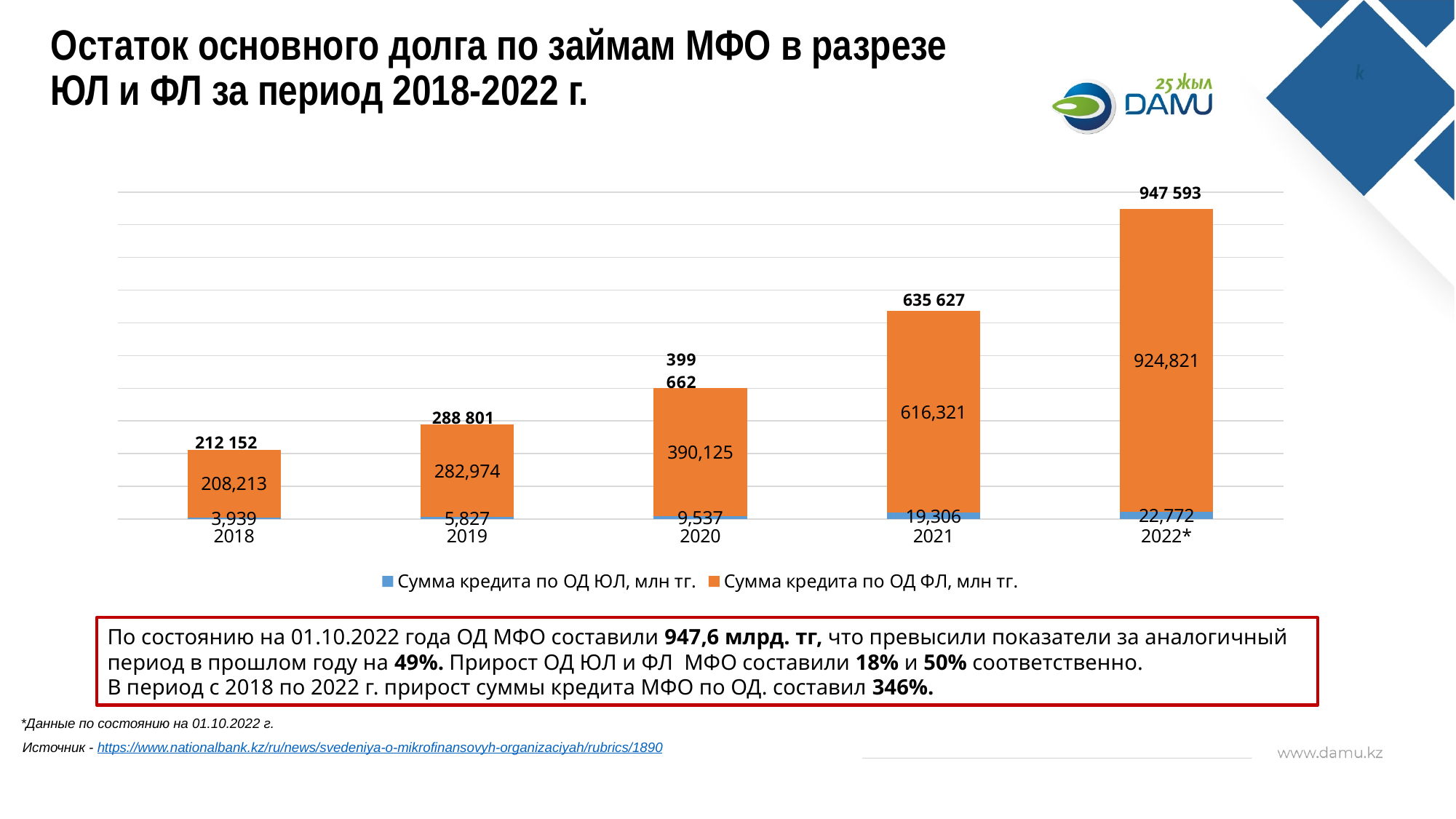
What is the value of "Сумма кредита по ОД ФЛ, млн тг." for 2020? 390,125 Which year has the lowest value for "Сумма кредита по ОД ЮЛ, млн тг."? 2018 What is the value of "Сумма кредита по ОД ЮЛ, млн тг." for 2021? 19,306 What kind of chart is shown on the slide? Stacked bar chart Which year has the highest value for "Сумма кредита по ОД ФЛ, млн тг."? 2022* What is the difference between the "Сумма кредита по ОД ФЛ, млн тг." values for 2022* and 2021? 308,500 What total is printed above the bar for 2022*? 947 593 Do the total values of the stacked bars rise or fall from 2018 to 2022*? Rise How many series does the legend list? 2 Which year has the larger value for "Сумма кредита по ОД ЮЛ, млн тг.": 2019 or 2020? 2020 What is the difference between the "Сумма кредита по ОД ЮЛ, млн тг." values for 2021 and 2020? 9,769 How many years are shown on the x axis of the chart? 5